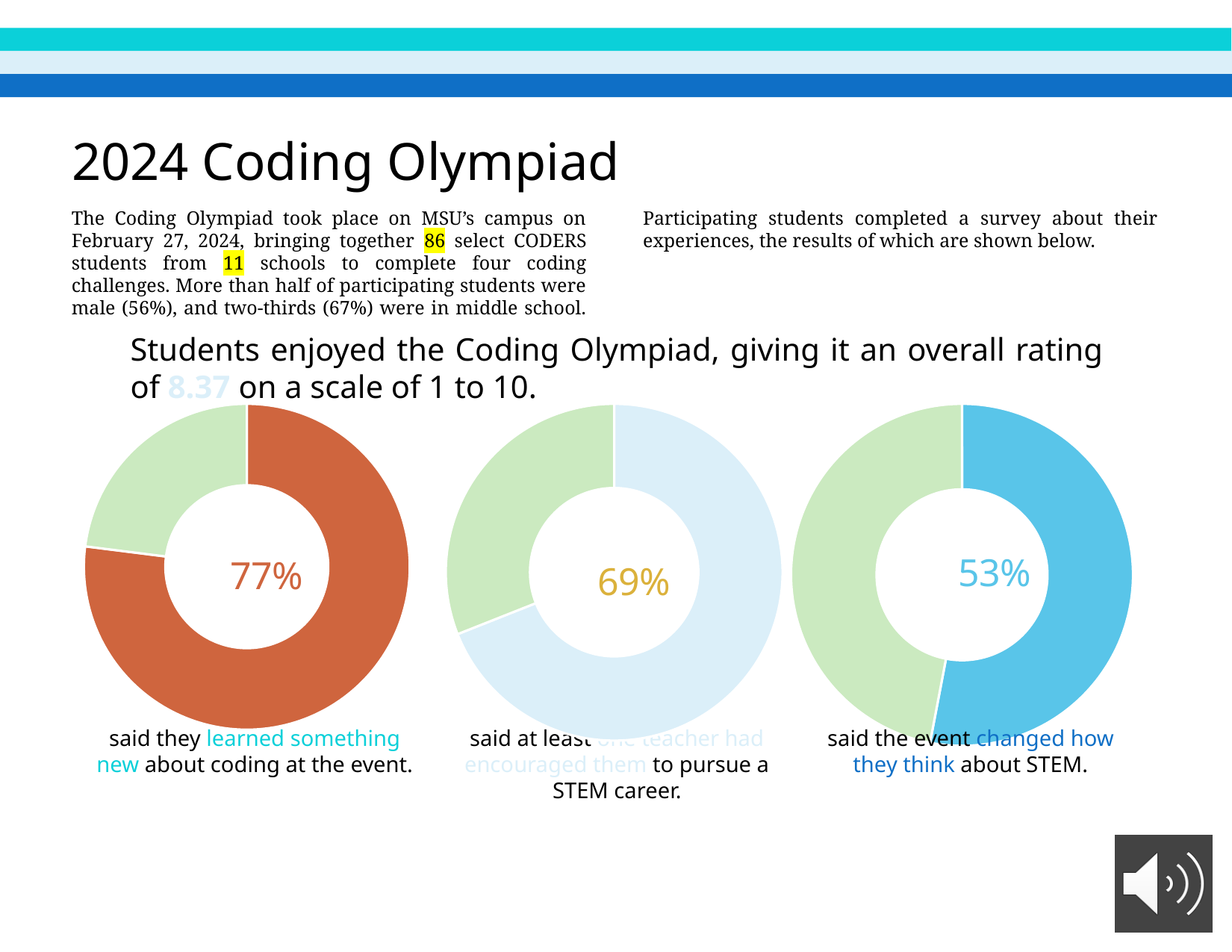
What colour is the larger slice of the left donut chart? Orange-red (rust) What percentage is shown in the centre of the middle donut chart (students who said at least one teacher had encouraged them to pursue a STEM career)? 69% How many donut charts are shown on the slide? 3 What type of chart is used to show the survey results on the slide? Donut (pie) chart What is the difference between the percentage in the left donut chart and the percentage in the middle donut chart? 8 percentage points What percentage is shown in the centre of the right donut chart (students who said the event changed how they think about STEM)? 53% Which of the three donut charts shows the highest percentage? The left chart (learned something new about coding), 77% Which is larger: the percentage in the middle donut chart or the percentage in the right donut chart? The middle donut chart (69%) Which of the three donut charts shows the lowest percentage? The right chart (changed how they think about STEM), 53% What is the difference between the percentage in the left donut chart and the percentage in the right donut chart? 24 percentage points What percentage is shown in the centre of the left donut chart (students who learned something new about coding)? 77% How many slices does each donut chart have? 2